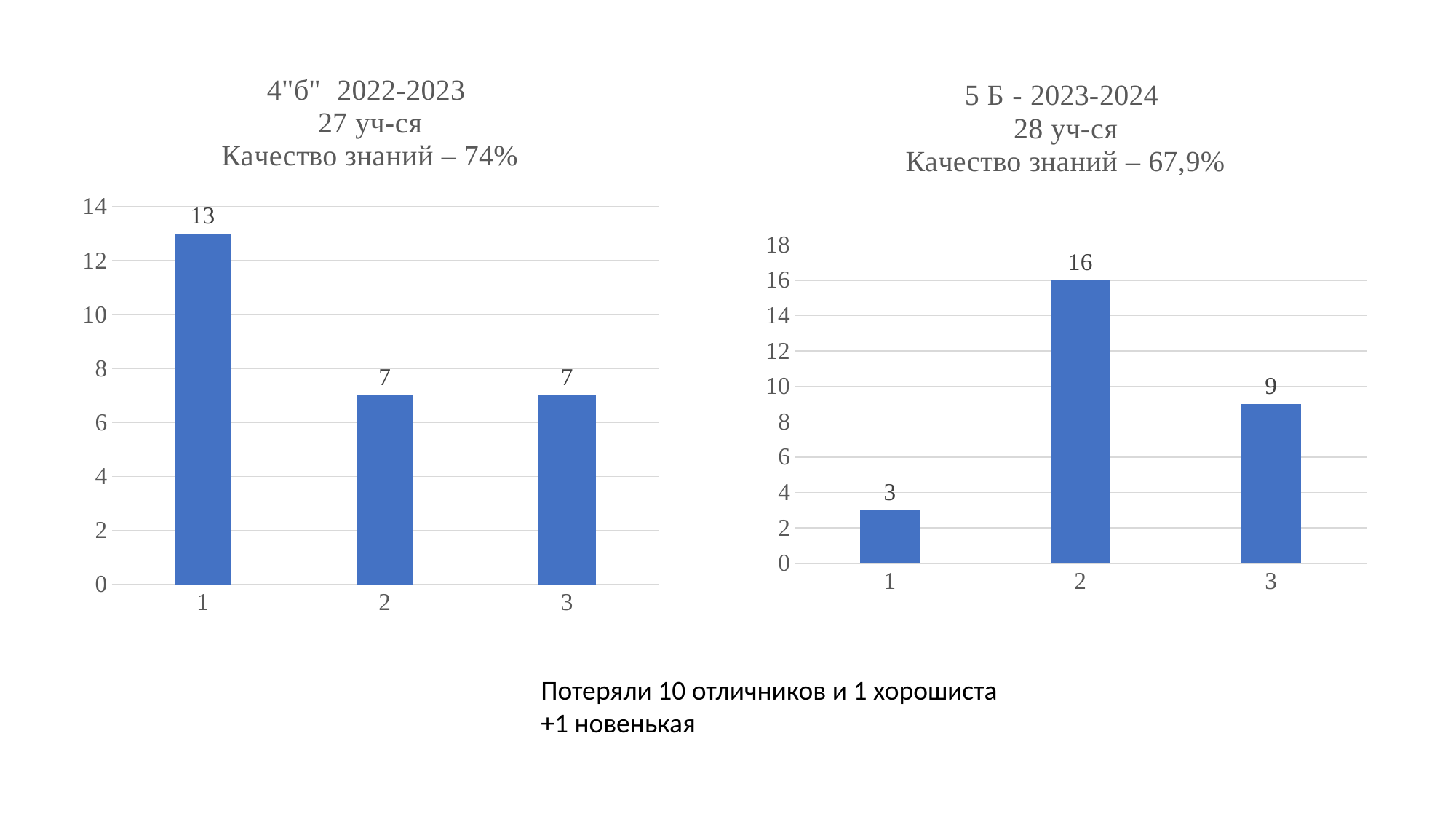
In the left chart (4"б" 2022-2023), what is the difference between the values for category 1 and category 2? 6 In the left chart (4"б" 2022-2023), what is the value for category 2? 7 In the right chart (5 Б - 2023-2024), which is larger: the value for category 3 or the value for category 1? category 3 How many bars are in the left chart (4"б" 2022-2023)? 3 In the right chart (5 Б - 2023-2024), which category has the lowest value? 1 What kind of chart is the right chart (5 Б - 2023-2024)? bar chart According to the title of the right chart, what is the 'Качество знаний' value for 5 Б - 2023-2024? 67,9% In the right chart (5 Б - 2023-2024), what is the value for category 2? 16 In the left chart (4"б" 2022-2023), which category has the highest value? 1 In the right chart (5 Б - 2023-2024), what is the value for category 3? 9 In the right chart (5 Б - 2023-2024), what is the difference between the values for category 2 and category 1? 13 In the left chart (4"б" 2022-2023), what is the value for category 1? 13